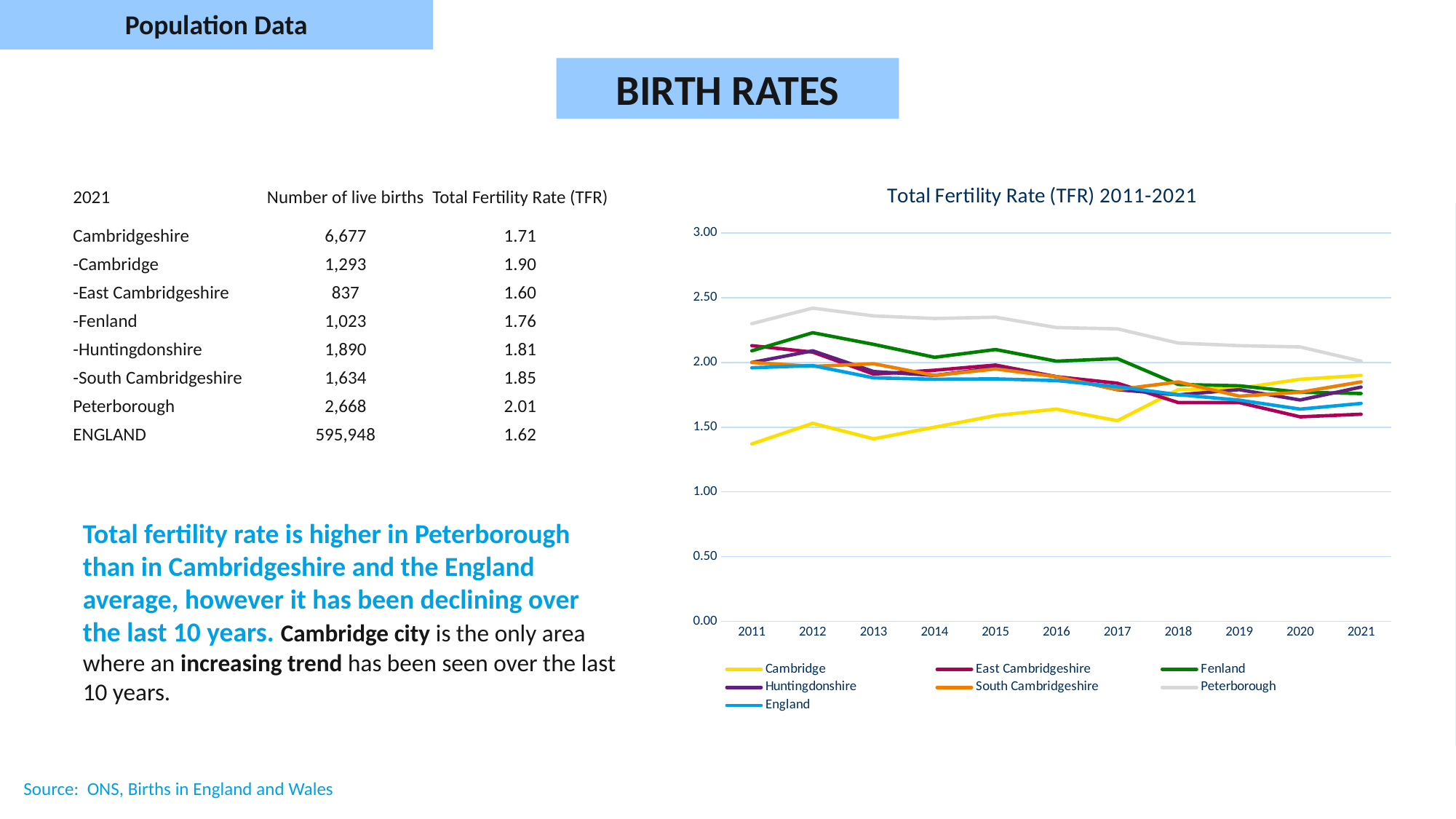
In the 'Total Fertility Rate (TFR) 2011-2021' chart, what colour is the Cambridge line? Yellow In the 'Total Fertility Rate (TFR) 2011-2021' chart, which area has the highest value in 2011? Peterborough In the 'Total Fertility Rate (TFR) 2011-2021' chart, which is larger in 2012: Peterborough or Cambridge? Peterborough In the 'Total Fertility Rate (TFR) 2011-2021' chart, which area has the lowest value in 2014? Cambridge In the 'Total Fertility Rate (TFR) 2011-2021' chart, does the Peterborough line generally rise or fall from 2011 to 2021? Fall In the 'Total Fertility Rate (TFR) 2011-2021' chart, which area has the lowest value in 2011? Cambridge In the 'Total Fertility Rate (TFR) 2011-2021' chart, is the value for Peterborough in 2012 greater or less than 2.00? greater How many years are shown on the x axis of the 'Total Fertility Rate (TFR) 2011-2021' chart? 11 How many series does the legend of the 'Total Fertility Rate (TFR) 2011-2021' chart list? 7 In the 'Total Fertility Rate (TFR) 2011-2021' chart, is the value for Cambridge in 2011 greater or less than 1.50? less What kind of chart is 'Total Fertility Rate (TFR) 2011-2021'? Line chart In the 'Total Fertility Rate (TFR) 2011-2021' chart, does the Cambridge line generally rise or fall from 2011 to 2021? Rise